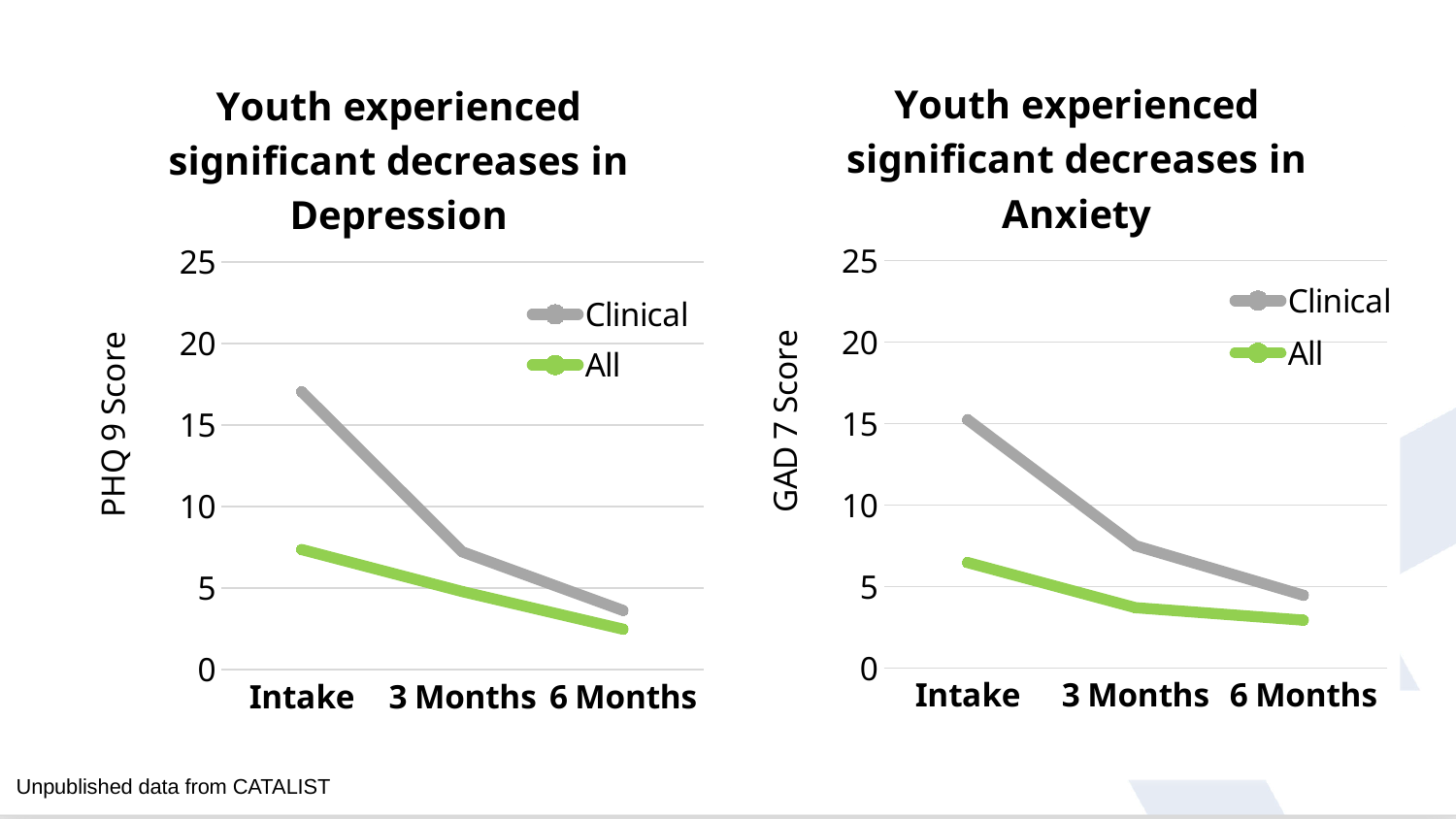
In the 'Youth experienced significant decreases in Anxiety' chart, which series has the higher value at Intake, Clinical or All? Clinical In the 'Youth experienced significant decreases in Depression' chart, does the Clinical series rise or fall from Intake to 6 Months? fall In the 'Youth experienced significant decreases in Anxiety' chart, is the Clinical value at Intake greater or less than 10? greater In the 'Youth experienced significant decreases in Anxiety' chart, does the All series rise or fall from Intake to 6 Months? fall In the 'Youth experienced significant decreases in Depression' chart, at which time point is the Clinical series highest? Intake In the 'Youth experienced significant decreases in Depression' chart, is the All value at Intake greater or less than 10? less How many time points are shown on the x axis of the 'Youth experienced significant decreases in Depression' chart? 3 What is the y-axis label of the 'Youth experienced significant decreases in Anxiety' chart? GAD 7 Score In the 'Youth experienced significant decreases in Depression' chart, is the Clinical value at Intake greater or less than 15? greater What kind of chart is the 'Youth experienced significant decreases in Depression' chart? line chart How many series does the legend list in the 'Youth experienced significant decreases in Anxiety' chart? 2